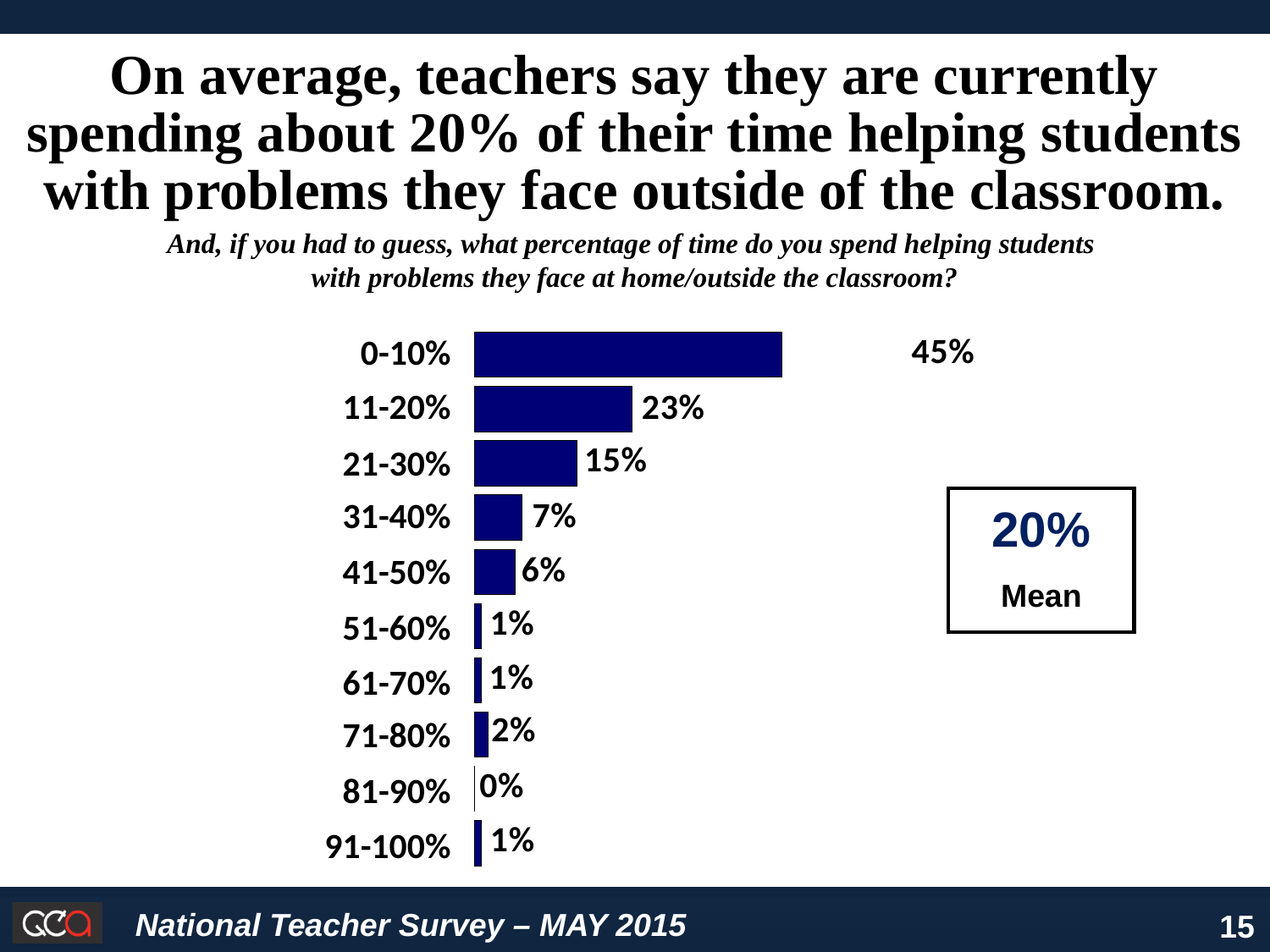
Which category has the highest value? 0-10% Which category has the lowest value? 81-90% What is the value shown for the 21-30% category? 15% What kind of chart is shown on the slide? Bar chart What mean value is shown in the box next to the chart? 20% What is the difference between the values for 21-30% and 31-40%? 8% How many categories are shown in the chart? 10 What percentage of teachers said they spend 0-10% of their time helping students with problems outside the classroom? 45% What is the value shown for the 41-50% category? 6% What is the value shown for the 11-20% category? 23% Which is larger, the value for 31-40% or the value for 41-50%? 31-40% What is the difference between the values for 0-10% and 11-20%? 22%